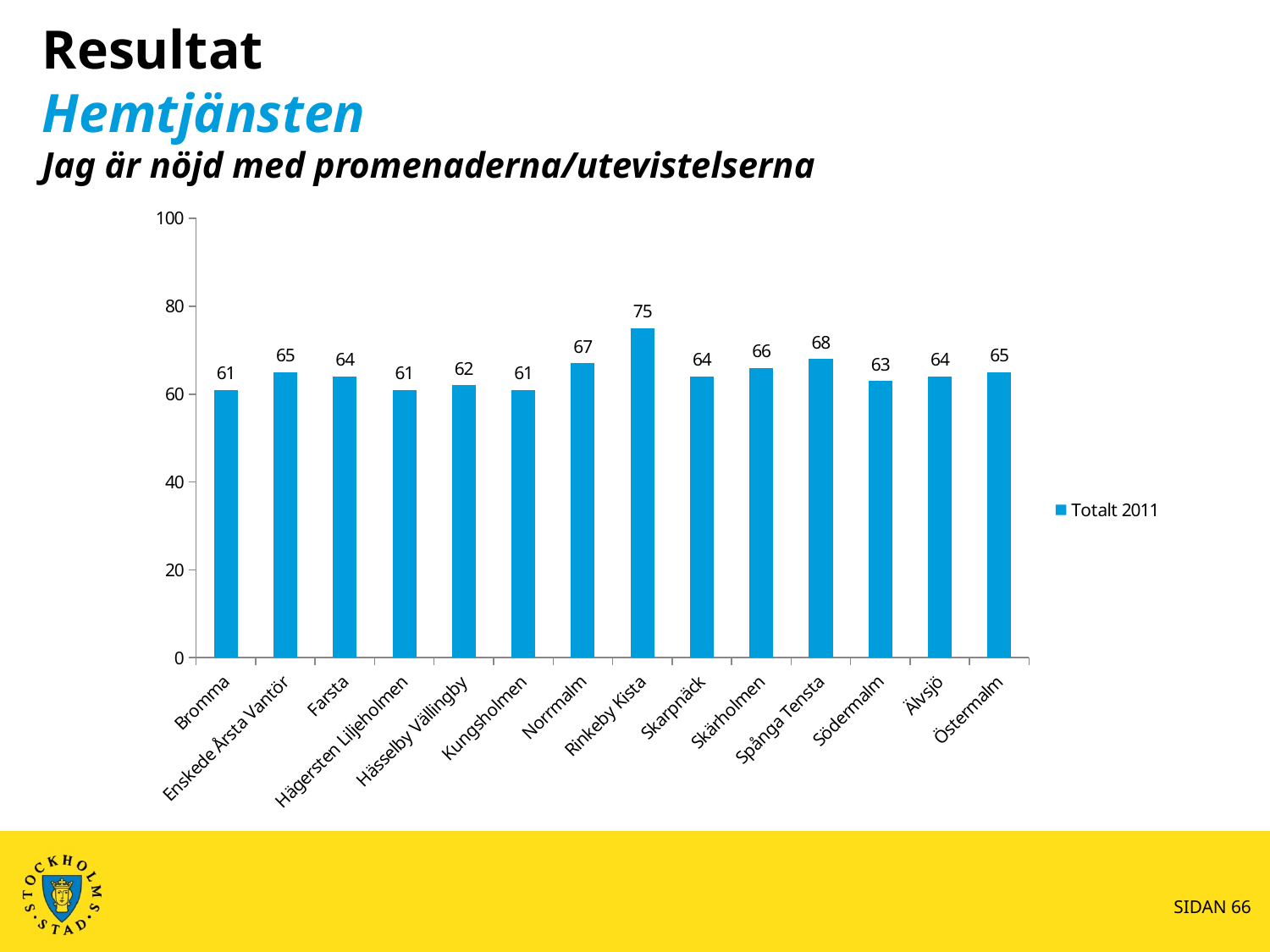
What is the difference between the values for Norrmalm and Kungsholmen? 6 How many series does the legend list? 1 Is the value for Rinkeby Kista greater or less than 80? less Which is larger, the value for Skärholmen or the value for Skarpnäck? Skärholmen How many districts are shown on the x axis? 14 What is the value for Spånga Tensta? 68 What is the difference between the values for Rinkeby Kista and Bromma? 14 Which district has the highest value? Rinkeby Kista What is the value for Rinkeby Kista? 75 What kind of chart is shown on the slide? bar chart What is the value for Södermalm? 63 What is the value for Hässelby Vällingby? 62